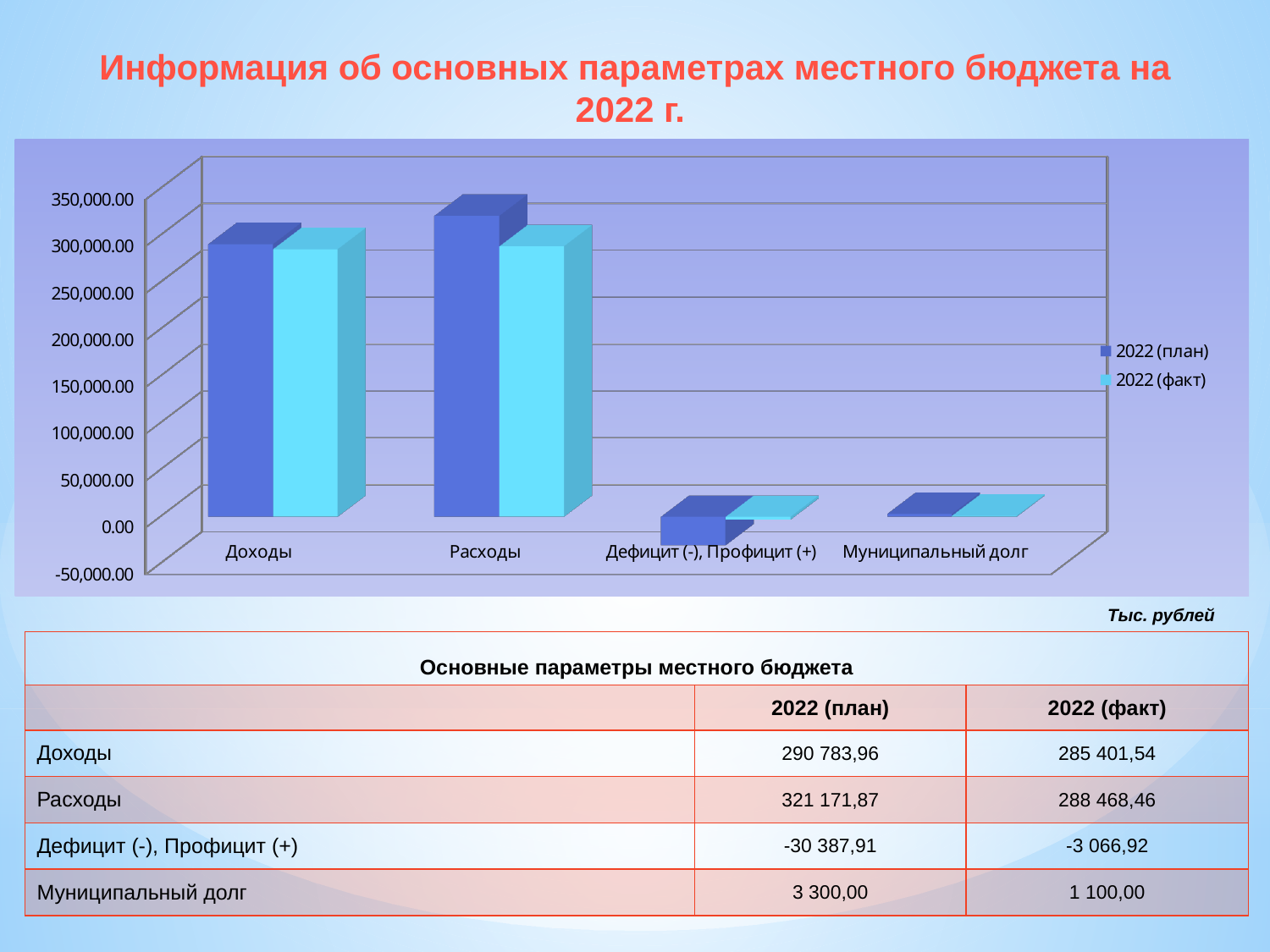
What is the value of Доходы for 2022 (план)? 290 783,96 For Расходы, which is larger: 2022 (план) or 2022 (факт)? 2022 (план) What is the value of Расходы for 2022 (факт)? 288 468,46 Is the 2022 (план) value for Расходы greater or less than 300,000.00? greater How many categories are shown along the x axis of the chart? 4 What are the two series named in the chart legend? 2022 (план) and 2022 (факт) What is the difference between the 2022 (план) and 2022 (факт) values for Расходы? 32 703,41 What kind of chart is shown on the slide? bar chart What is the value of Муниципальный долг for 2022 (факт)? 1 100,00 Which category has the highest 2022 (план) value? Расходы How many series does the chart legend list? 2 Which category has the lowest 2022 (план) value? Дефицит (-), Профицит (+)